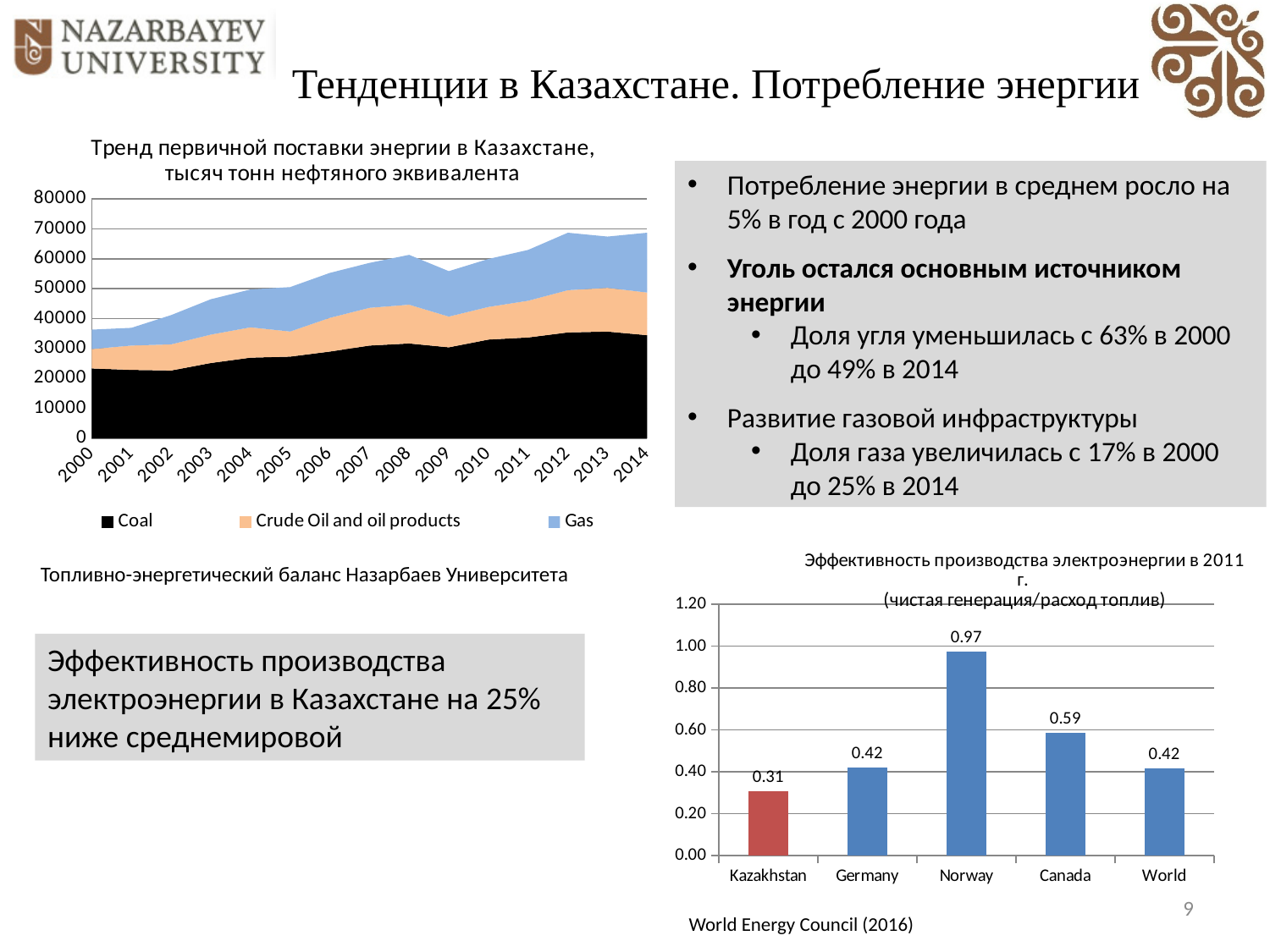
In the bottom-right chart (Эффективность производства электроэнергии в 2011 г.), how many categories are shown on the x axis? 5 In the bottom-right chart (Эффективность производства электроэнергии в 2011 г.), which country has the highest value? Norway In the bottom-right chart (Эффективность производства электроэнергии в 2011 г.), what is the value for Kazakhstan? 0.31 In the bottom-right chart (Эффективность производства электроэнергии в 2011 г.), which is larger, the value for Canada or the value for Germany? Canada In the bottom-right chart (Эффективность производства электроэнергии в 2011 г.), what is the value for Norway? 0.97 In the bottom-right chart (Эффективность производства электроэнергии в 2011 г.), what is the value for Canada? 0.59 What kind of chart is the bottom-right chart (Эффективность производства электроэнергии в 2011 г.)? Bar chart In the bottom-right chart (Эффективность производства электроэнергии в 2011 г.), what is the difference between the values for Norway and Canada? 0.38 In the top-left chart (Тренд первичной поставки энергии в Казахстане), does the total primary energy supply generally rise or fall from 2000 to 2014? Rise In the top-left chart (Тренд первичной поставки энергии в Казахстане), how many series does the legend list? 3 In the bottom-right chart (Эффективность производства электроэнергии в 2011 г.), which category has the lowest value? Kazakhstan In the top-left chart (Тренд первичной поставки энергии в Казахстане), is the total primary energy supply in 2014 greater or less than 60000? greater